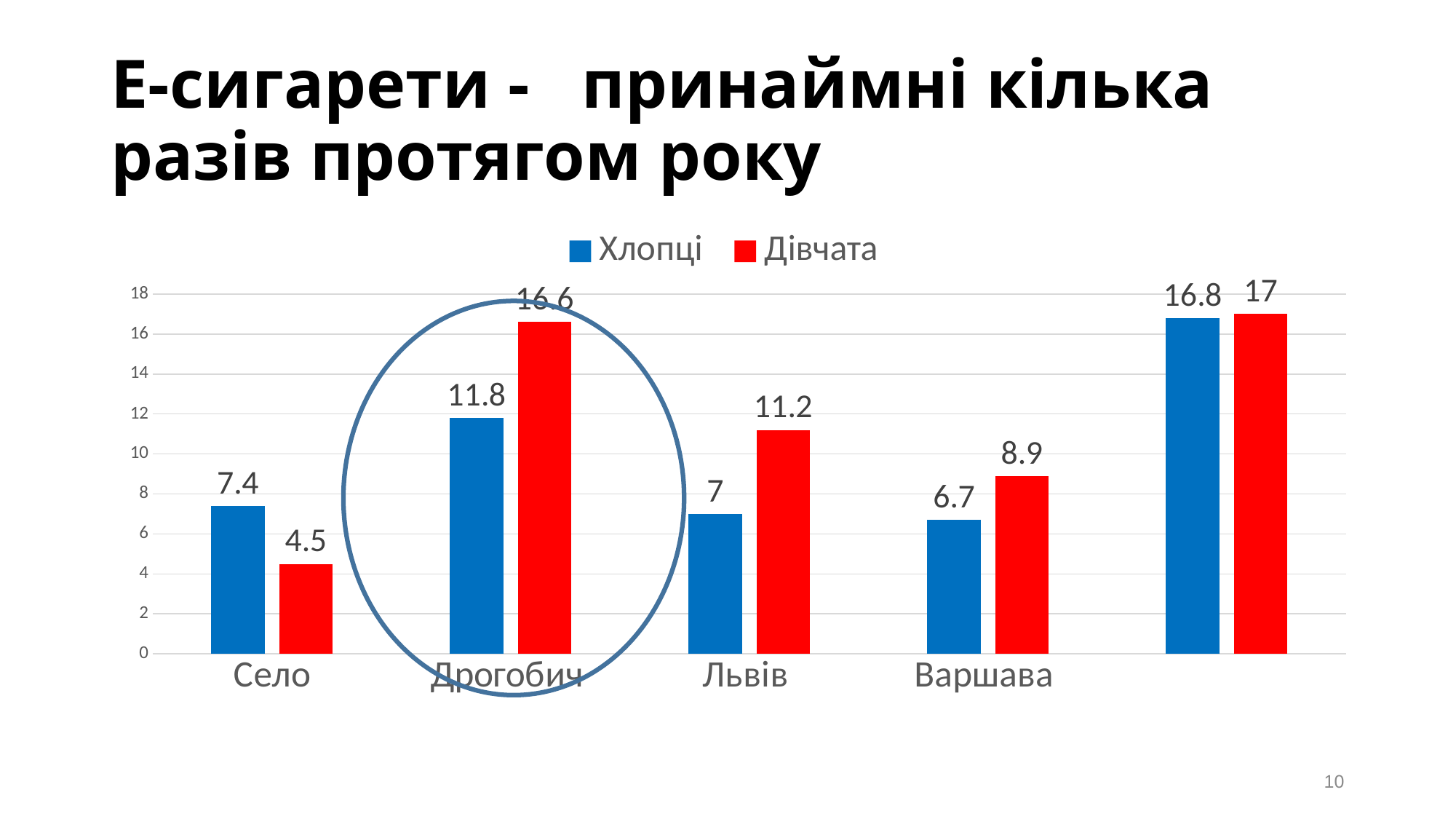
What is the difference between the Дівчата and Хлопці values in Дрогобич? 4.8 What is the difference between the Хлопці and Дівчата values in Село? 2.9 What kind of chart is shown on the slide? Bar chart Which is larger in Львів, the Хлопці value or the Дівчата value? Дівчата Which category on the chart is circled? Дрогобич How many series does the legend list? 2 Which category has the lowest Хлопці value? Варшава What is the value for Дівчата in Варшава? 8.9 What is the value for Хлопці in Львів? 7 What is the value for Хлопці in Село? 7.4 What is the value for Дівчата in Дрогобич? 16.6 Which category has the lowest Дівчата value? Село